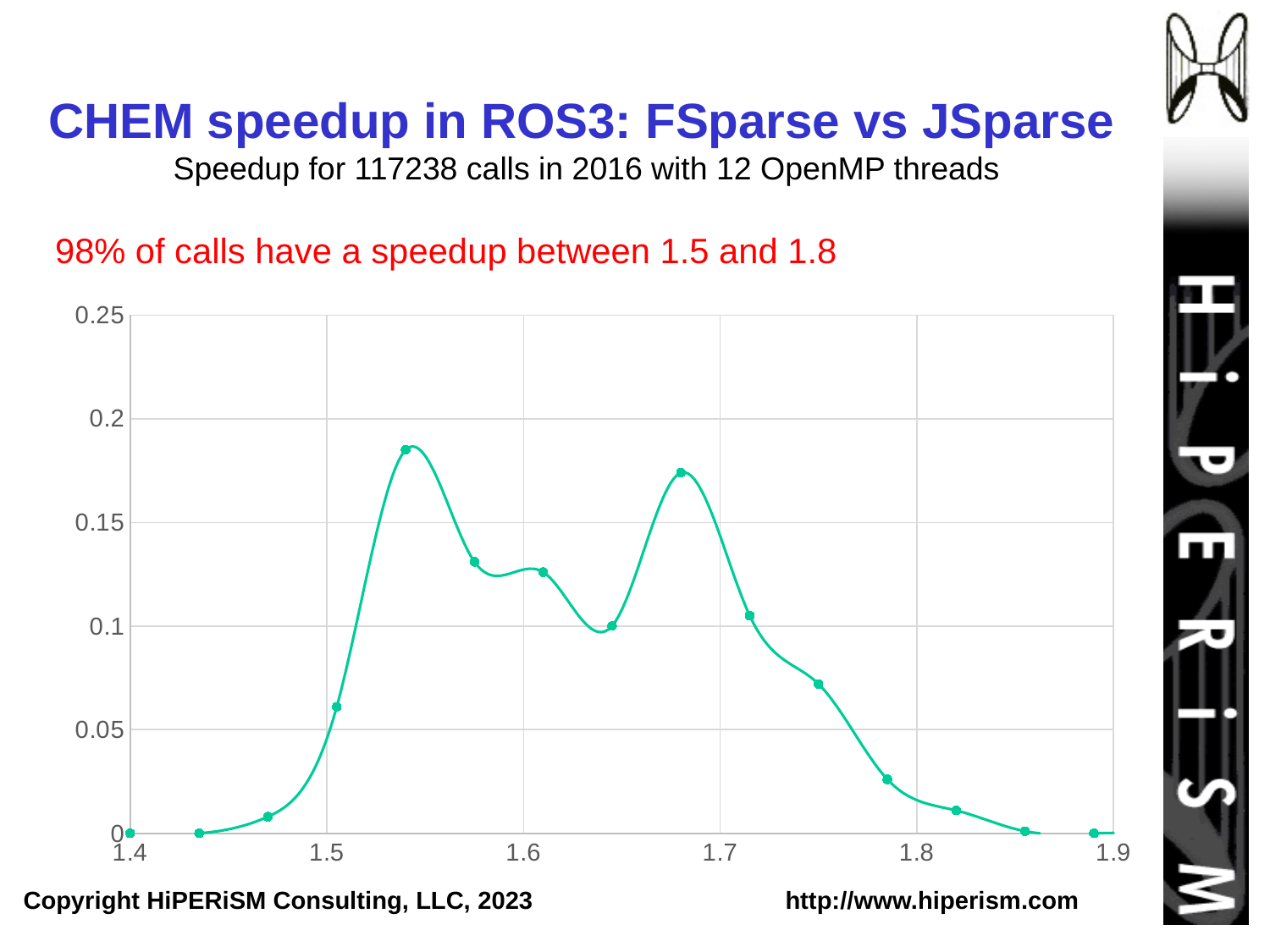
Which of the two peaks is higher, the one near x = 1.54 or the one near x = 1.68? the one near x = 1.54 Is the value at the right-hand peak (near x = 1.68) greater or less than 0.15? greater What is the title of the slide's chart? CHEM speedup in ROS3: FSparse vs JSparse Is the value at x = 1.9 greater or less than 0.05? less Is the value at the left-hand peak (near x = 1.54) greater or less than 0.15? greater Do the values rise or fall along the x axis between 1.68 and 1.9? fall What is the highest value labelled on the y axis? 0.25 What kind of chart is shown on the slide? line chart Do the values rise or fall along the x axis between 1.4 and 1.54? rise